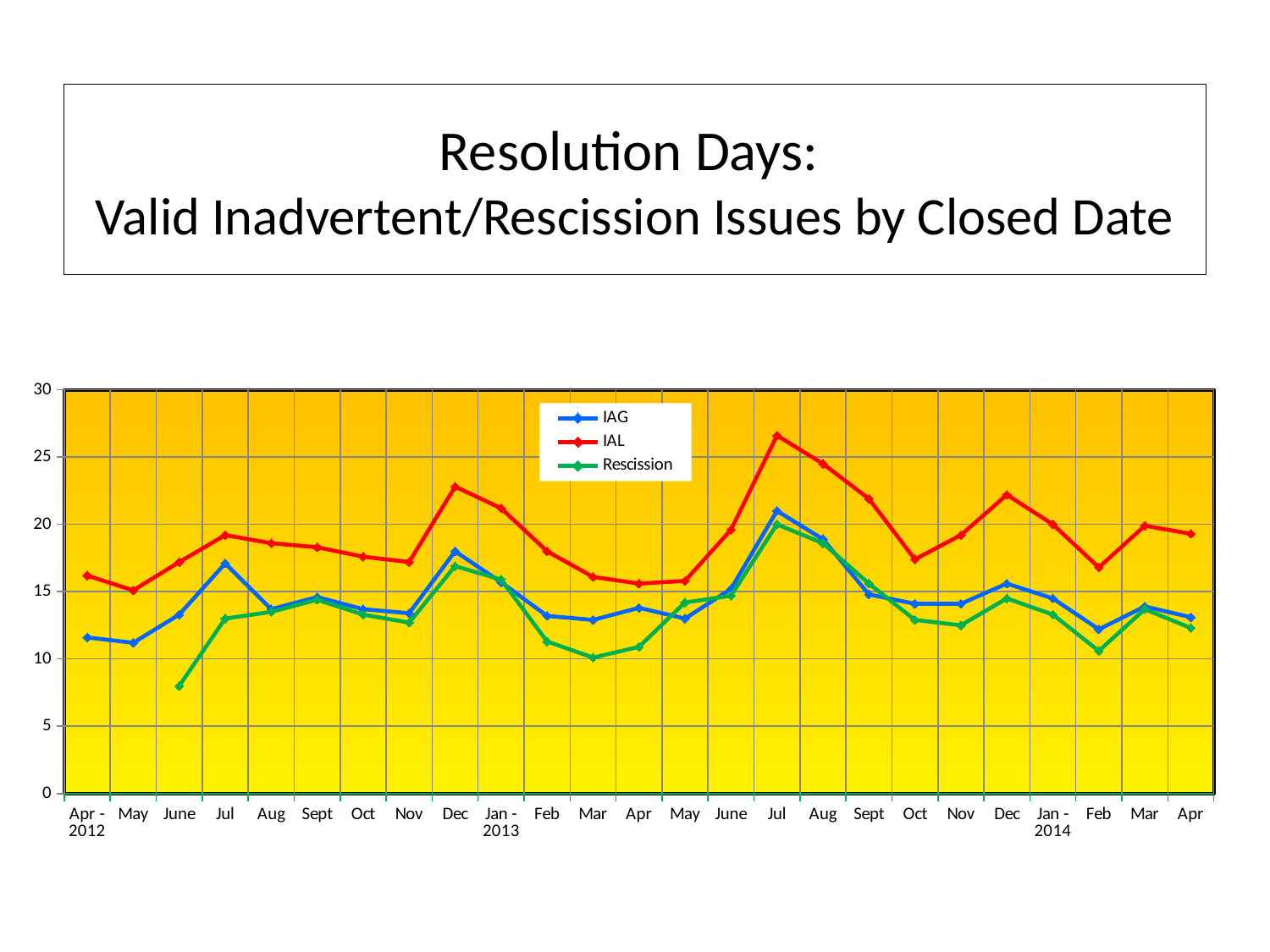
Is the Rescission value for June 2012 greater or less than 10? less How many months are plotted along the x axis? 25 How many series does the legend list? 3 Which series is drawn in red? IAL Does the IAL series rise or fall from Jul 2013 to Oct 2013? Fall In which month does the Rescission series have its lowest value? June 2012 Is the Rescission value for Mar 2013 greater or less than 15? less What kind of chart is shown on the slide? Line chart In which month does the IAL series reach its highest value? Jul 2013 Is the IAL value for Jul 2013 greater or less than 25? greater In Dec 2012, which series has the higher value, IAL or IAG? IAL